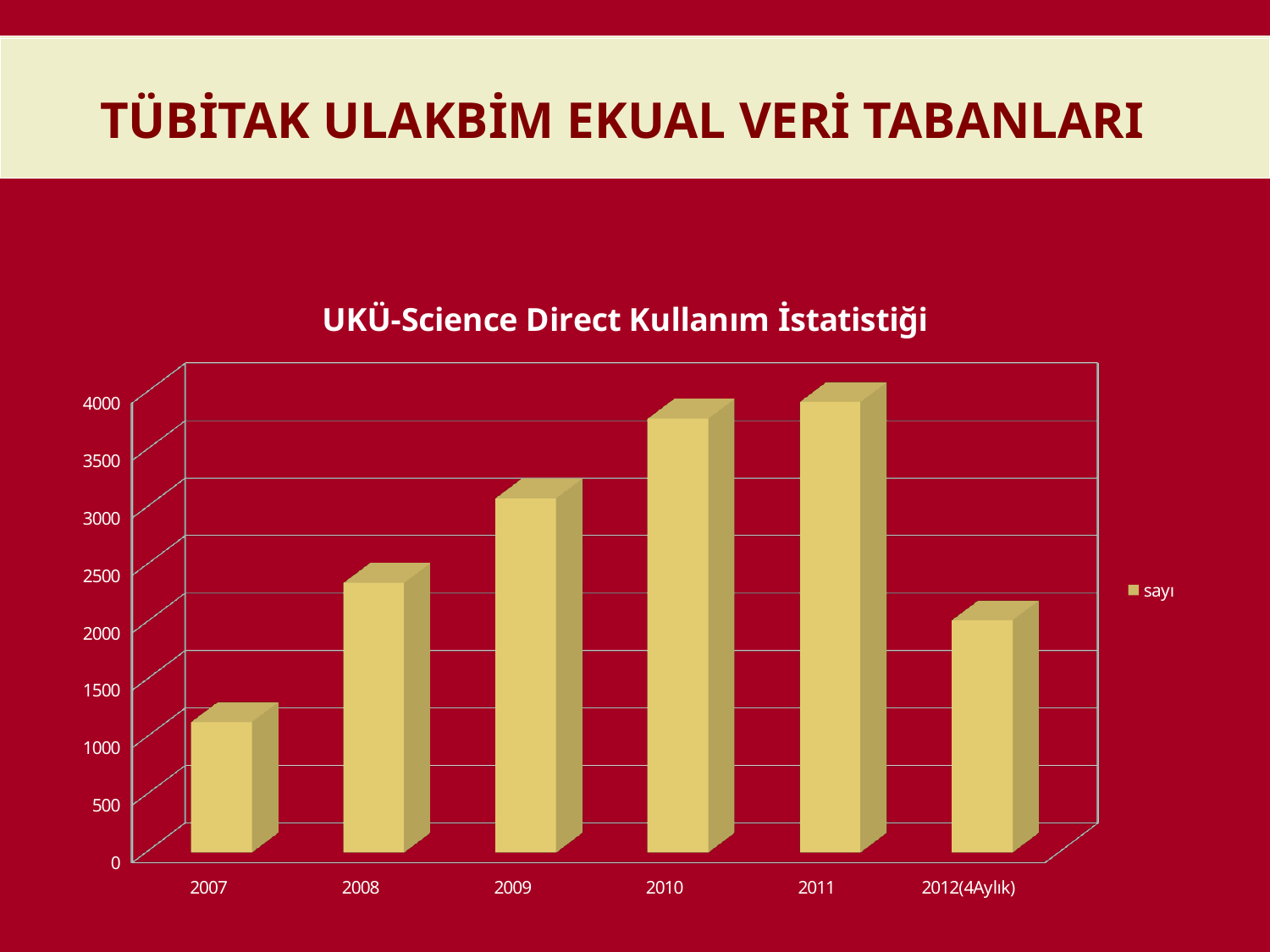
Which category has the lowest value in the chart? 2007 Do the values rise or fall from 2007 to 2011? rise Is the value for 2007 greater or less than 1500? less What type of chart is shown on the slide? bar chart What is the title of the chart? UKÜ-Science Direct Kullanım İstatistiği How many categories are shown on the x axis of the chart? 6 How many series does the legend list? 1 Is the value for 2010 greater or less than 3500? greater Is the value for 2008 greater or less than 2000? greater Which is larger, the value for 2010 or the value for 2008? 2010 Which year has the highest value in the chart? 2011 What is the name of the series shown in the legend? sayı